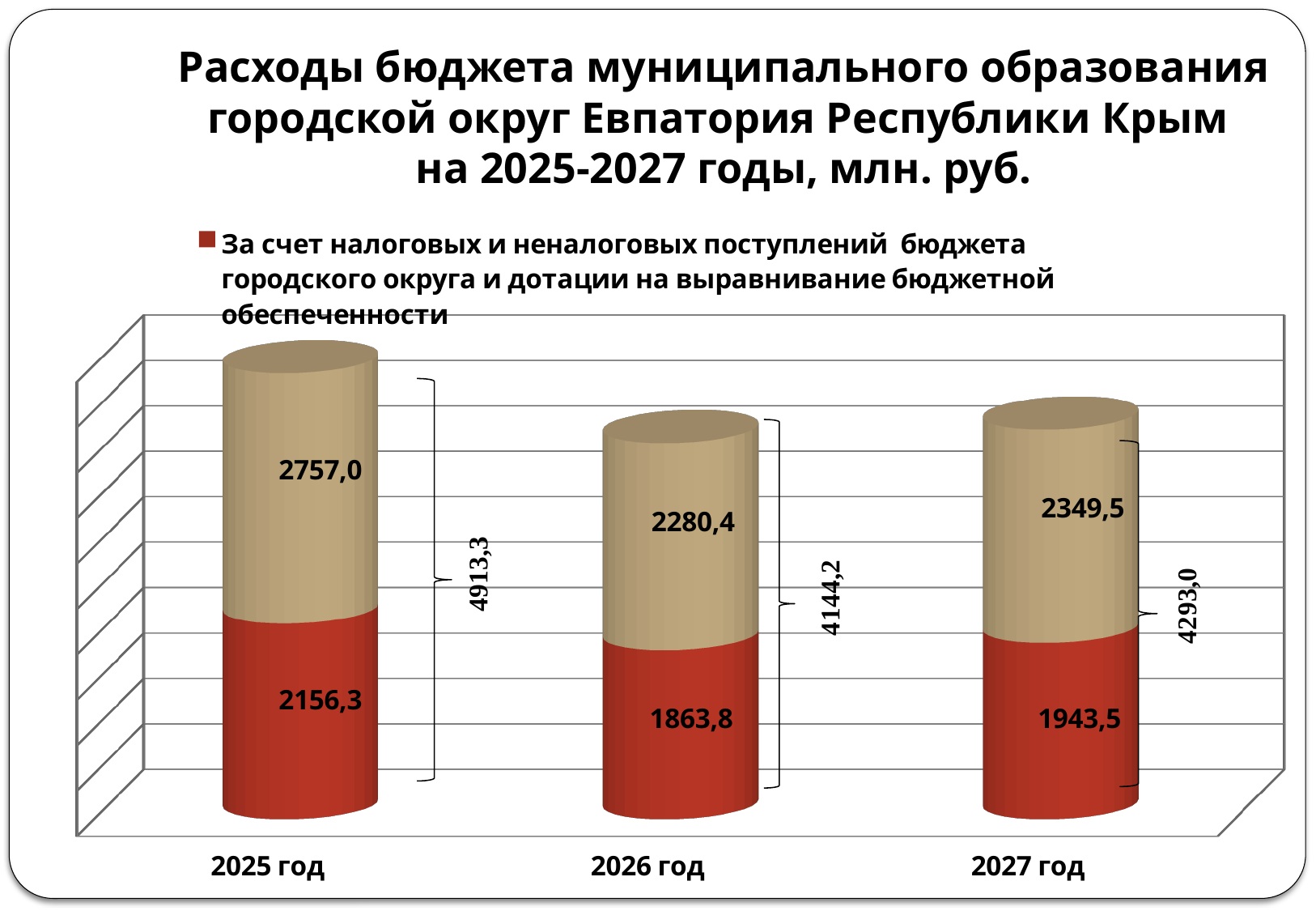
What type of chart is shown on the slide? bar chart How many series does the legend list? 1 Which year has the lowest value for the red segment? 2026 год What is the value of the beige (upper) segment for 2025 год? 2757,0 What is the difference between the beige segment values for 2025 год and 2026 год? 476,6 What is the value of the red segment for 2027 год? 1943,5 Which year has the highest total expenditure? 2025 год How many years (categories) are shown on the x axis? 3 What is the value of the red segment for 2026 год? 1863,8 What is the total of the stacked bar for 2026 год? 4144,2 What is the value of the red segment (за счет налоговых и неналоговых поступлений бюджета городского округа и дотации на выравнивание бюджетной обеспеченности) for 2025 год? 2156,3 What is the total of the stacked bar for 2027 год? 4293,0